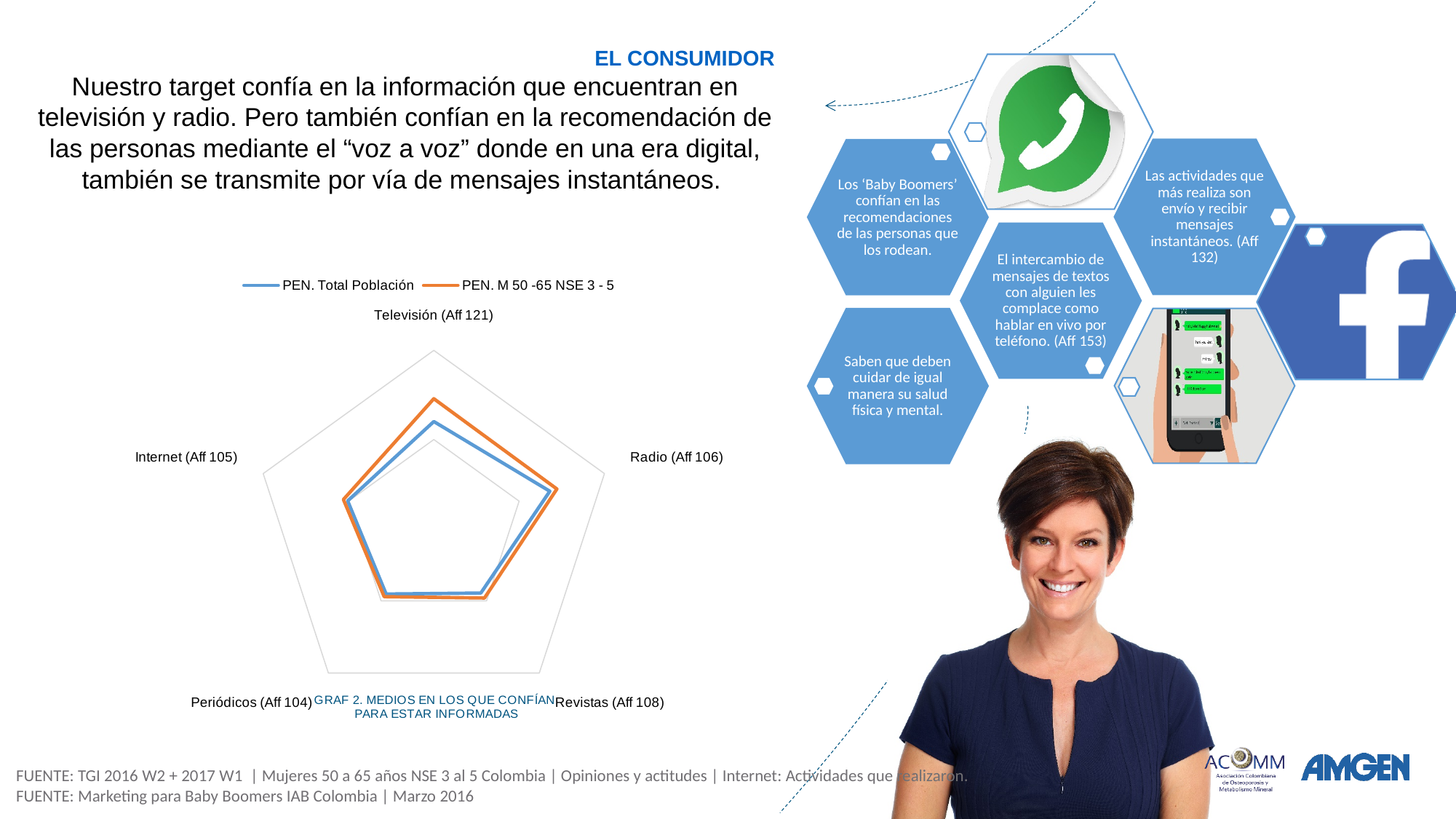
What Aff value is shown in the label for Televisión? 121 What are the two series named in the legend of the radar chart? PEN. Total Población and PEN. M 50 -65 NSE 3 - 5 Which category has the highest Aff value in its label? Televisión At Televisión, which series has the larger plotted value: PEN. Total Población or PEN. M 50 -65 NSE 3 - 5? PEN. M 50 -65 NSE 3 - 5 What Aff value is shown in the label for Revistas? 108 How many series does the legend of the radar chart list? 2 What is the difference between the Aff value for Televisión and the Aff value for Periódicos? 17 What kind of chart is shown on the slide? Radar chart What Aff value is shown in the label for Periódicos? 104 Which category has the lowest Aff value in its label? Periódicos How many categories (axes) does the radar chart have? 5 What is the title of the radar chart? GRAF 2. MEDIOS EN LOS QUE CONFÍAN PARA ESTAR INFORMADAS